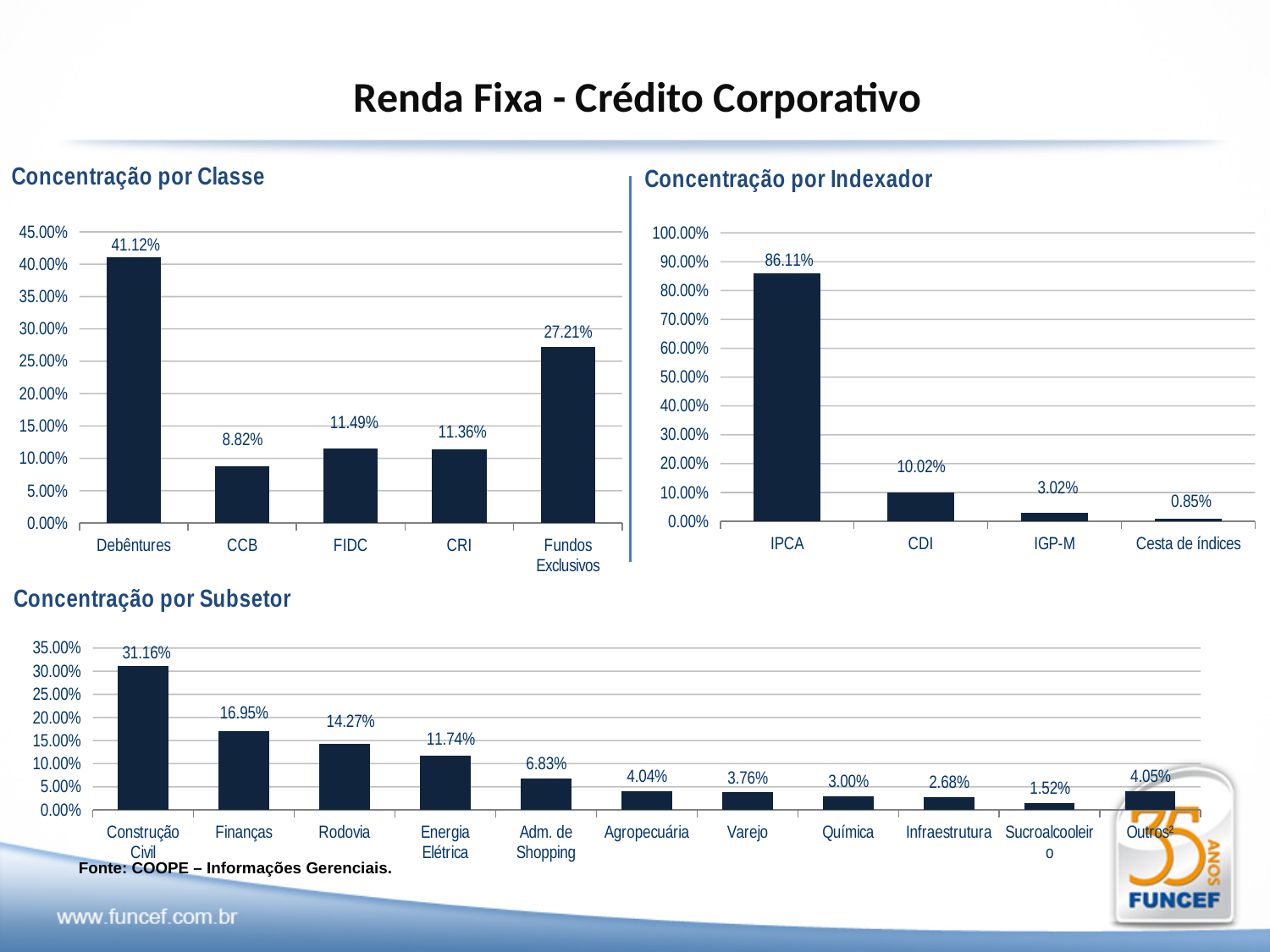
In the 'Concentração por Subsetor' chart, what is the value for Rodovia? 14.27% In the 'Concentração por Classe' chart, what is the difference between Debêntures and Fundos Exclusivos? 13.91% In the 'Concentração por Subsetor' chart, which is larger, Finanças or Energia Elétrica? Finanças In the 'Concentração por Indexador' chart, what is the value for CDI? 10.02% In the 'Concentração por Indexador' chart, which category has the highest value? IPCA In the 'Concentração por Classe' chart, which category has the lowest value? CCB In the 'Concentração por Classe' chart, what is the value for Debêntures? 41.12% In the 'Concentração por Indexador' chart, what is the value for Cesta de índices? 0.85% In the 'Concentração por Subsetor' chart, which category has the lowest value? Sucroalcooleiro In the 'Concentração por Classe' chart, how many categories are shown? 5 What type of chart is the 'Concentração por Indexador' chart? Bar chart In the 'Concentração por Subsetor' chart, how many categories are shown? 11